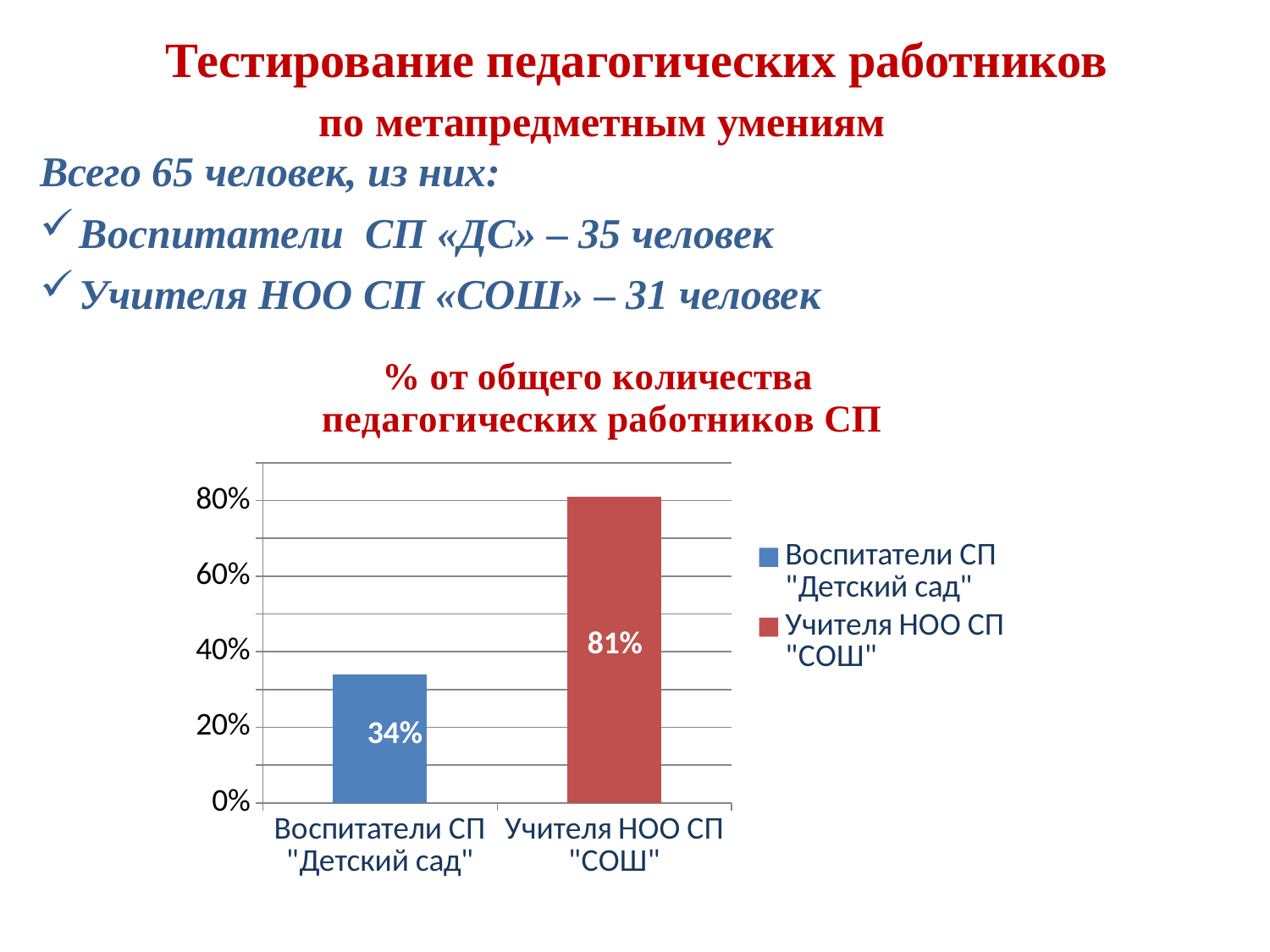
What is the title of the chart? % от общего количества педагогических работников СП What is the value for Учителя НОО СП "СОШ"? 81% Which category has the highest value? Учителя НОО СП "СОШ" What is the difference between the values for Учителя НОО СП "СОШ" and Воспитатели СП "Детский сад"? 47% Which category has the lowest value? Воспитатели СП "Детский сад" What is the value for Воспитатели СП "Детский сад"? 34% How many categories are shown on the chart? 2 Which is larger: the value for Воспитатели СП "Детский сад" or the value for Учителя НОО СП "СОШ"? Учителя НОО СП "СОШ" How many entries does the legend list? 2 Is the value for Воспитатели СП "Детский сад" greater or less than 40%? less Is the value for Учителя НОО СП "СОШ" greater or less than 60%? greater What kind of chart is shown on the slide? bar chart